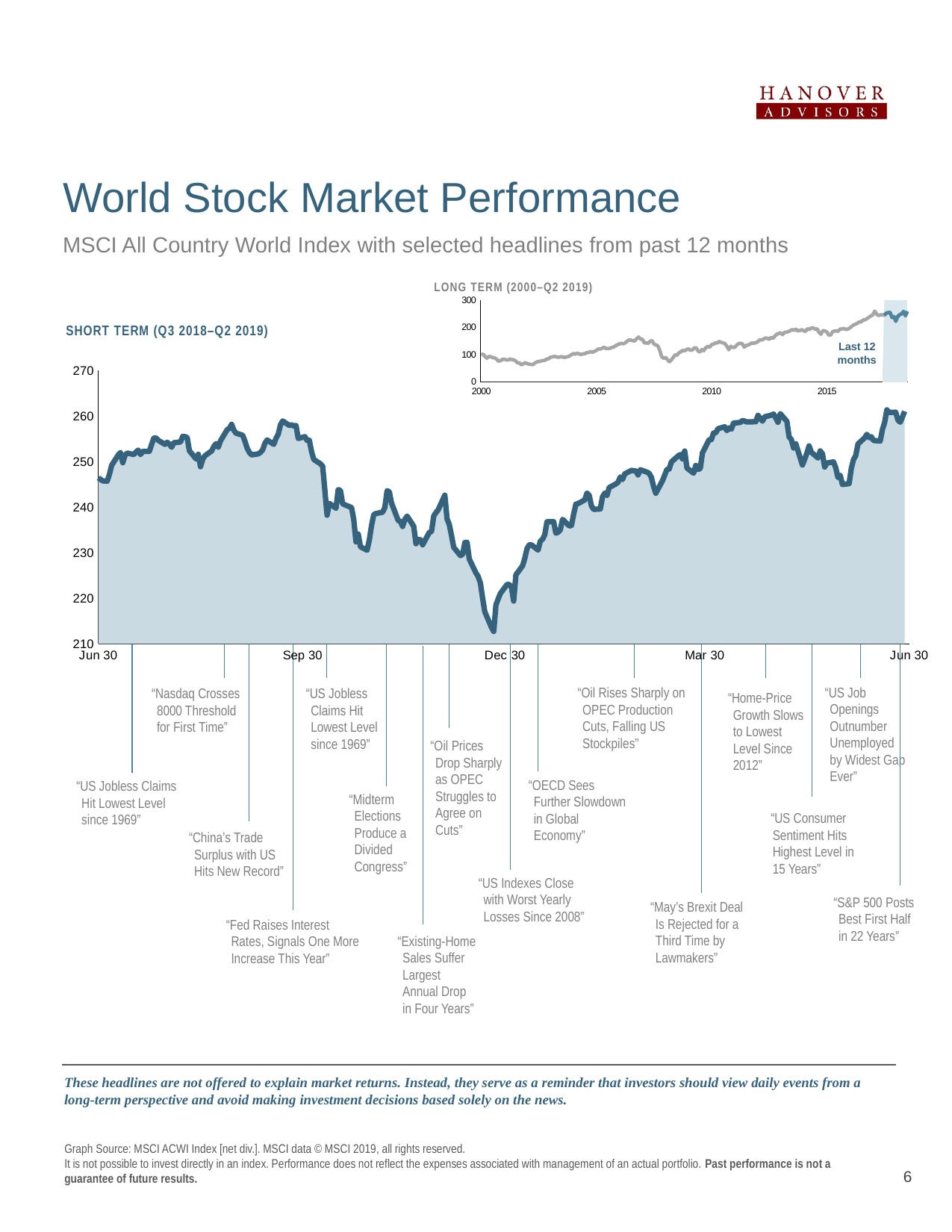
On the short-term chart, does the index rise or fall between Jun 30 and Dec 30? fall How many date labels are shown on the x axis of the short-term chart? 5 On the short-term chart, is the index value at Jun 30 (the start) greater or less than 250? less On the short-term chart, is the index value at Sep 30 greater or less than 250? greater On the short-term chart, is the index value at Jun 30 (the start) greater or less than 240? greater On the short-term chart, does the index rise or fall between Dec 30 and the final Jun 30? rise On the long-term chart (2000–Q2 2019), does the index overall rise or fall from 2000 to Q2 2019? rise What kind of chart is the short-term chart (Q3 2018–Q2 2019)? line chart What label is given to the shaded region at the right end of the long-term chart? Last 12 months